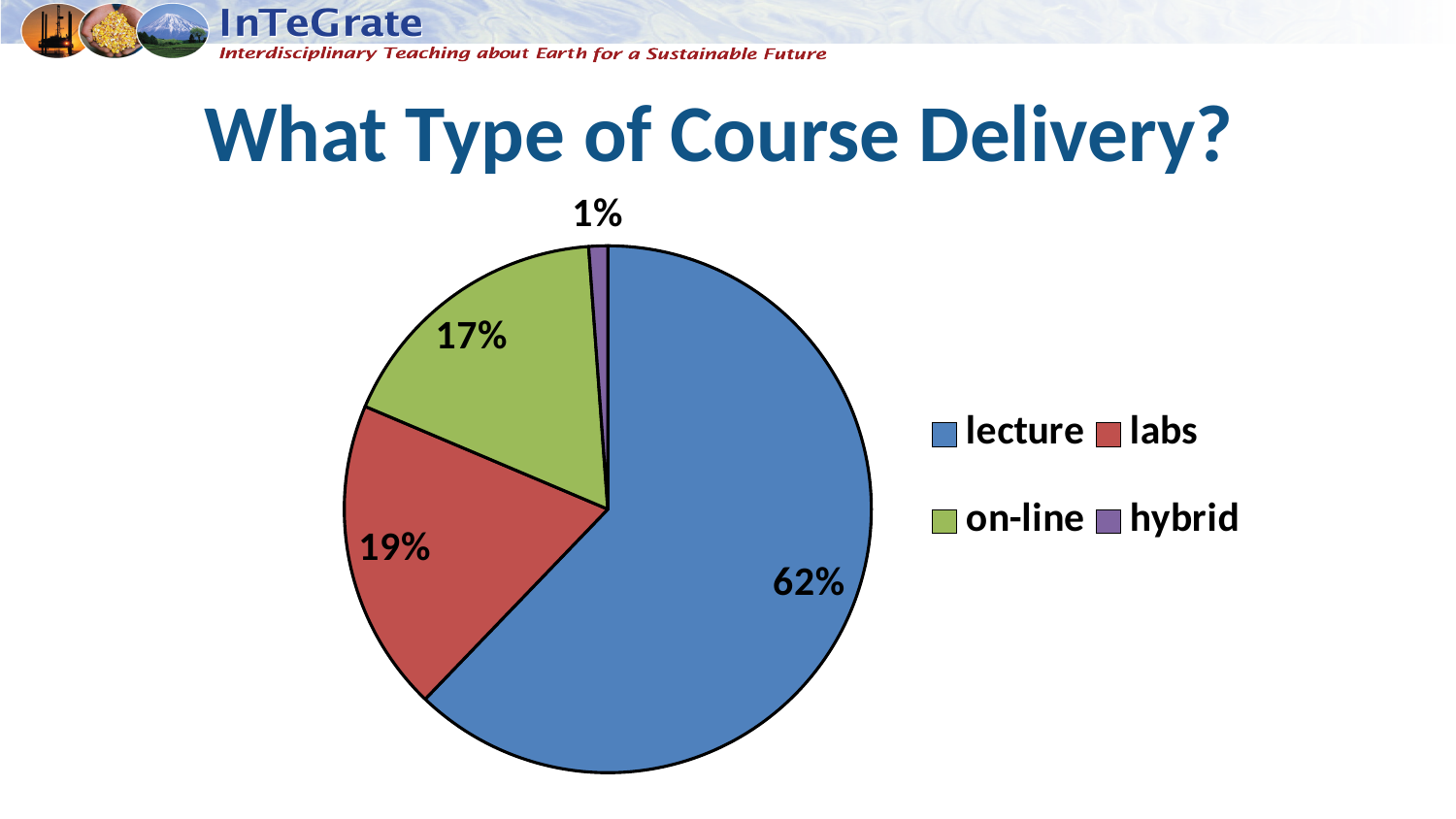
Which is larger, the share for labs or the share for on-line? labs What is the title of the slide? What Type of Course Delivery? What is the difference between the labs and on-line percentages? 2% Which course delivery type has the largest slice? lecture What is the value shown for on-line? 17% What is the value shown for labs? 19% What kind of chart is shown on the slide? pie chart What is the value shown for hybrid? 1% Which course delivery type has the smallest slice? hybrid What share of the pie does lecture account for? 62% How many slices does the pie chart have? 4 What is the difference between the lecture and labs percentages? 43%